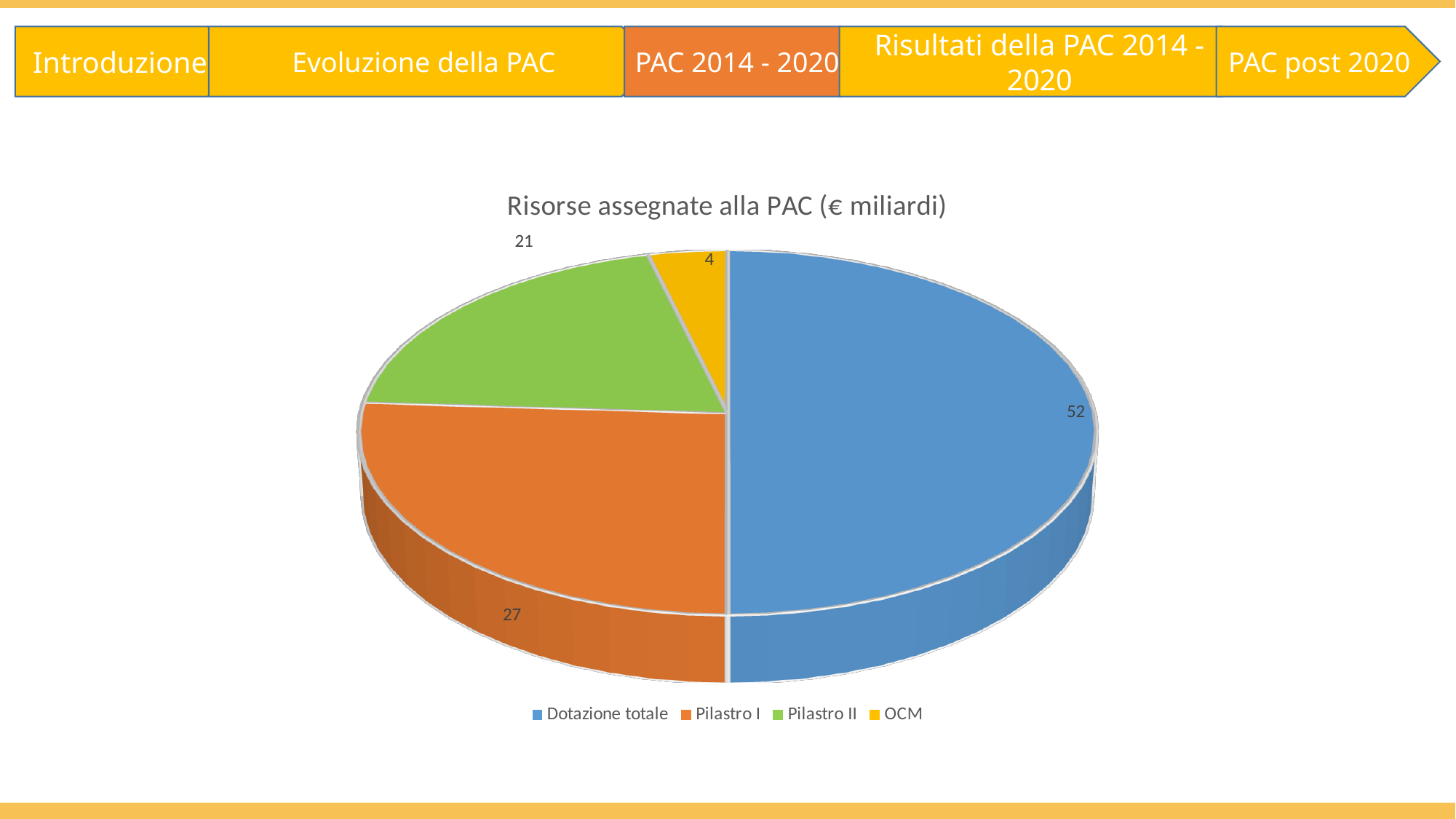
Which category has the largest slice? Dotazione totale Which category has the smallest slice? OCM What kind of chart is shown on the slide? pie chart Which is larger, the value for Pilastro I or the value for OCM? Pilastro I What share of the pie does the Dotazione totale slice represent? 50% What is the value for OCM? 4 What is the value for Dotazione totale? 52 How many slices does the pie chart have? 4 What is the title of the chart? Risorse assegnate alla PAC (€ miliardi) What is the value for Pilastro II? 21 What is the value for Pilastro I? 27 What is the difference between the values for Pilastro I and Pilastro II? 6